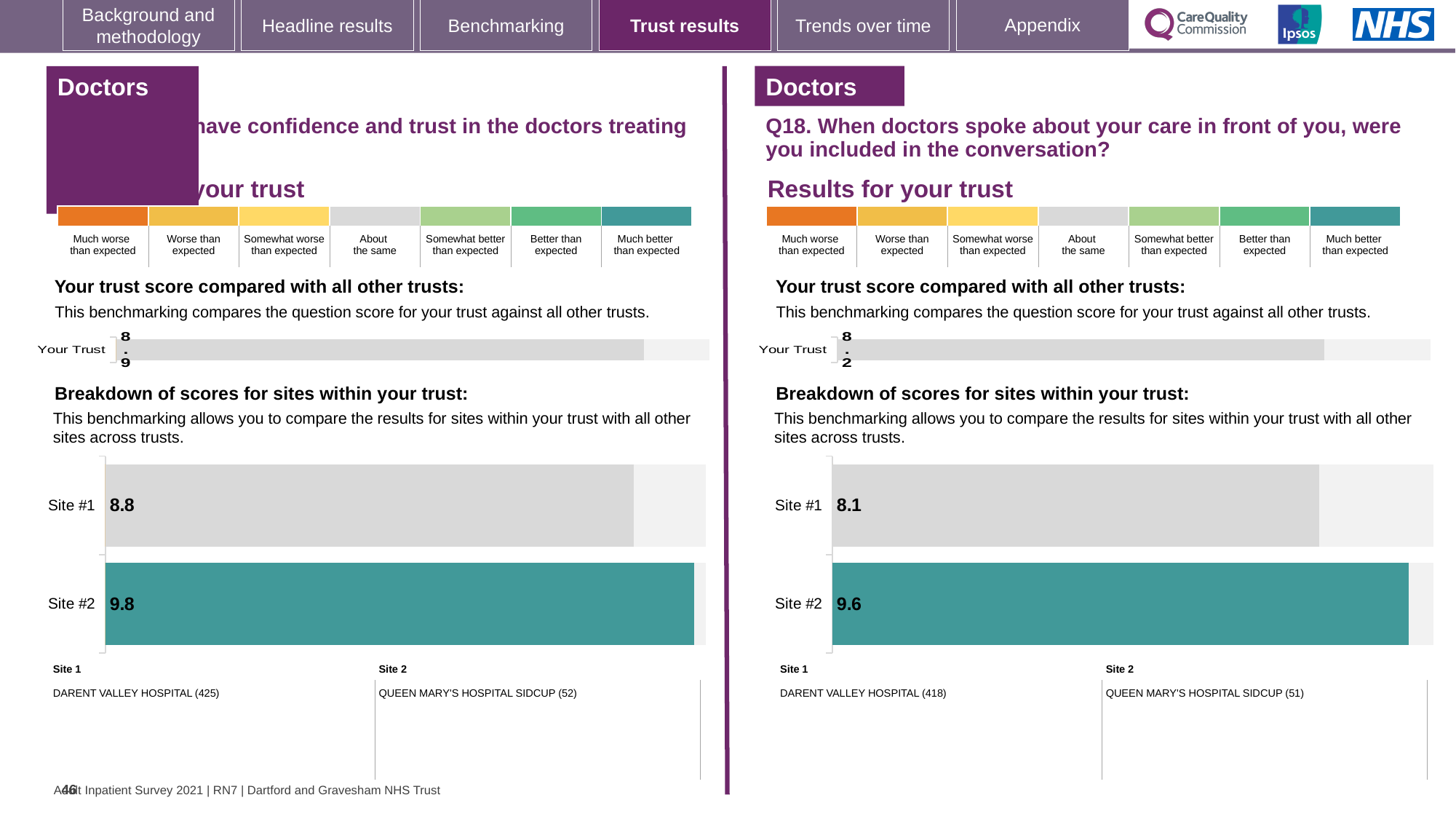
In the left-hand 'Breakdown of scores for sites within your trust' chart, what is the score for Site #1? 8.8 In the Q18 site breakdown chart on the right, how many sites are shown? 2 In the left-hand 'Your trust score compared with all other trusts' chart, what is the score for Your Trust? 8.9 In the left-hand site breakdown chart, what is the difference between the scores for Site #2 and Site #1? 1.0 In the Q18 site breakdown chart on the right, which site has the lowest score? Site #1 In the Q18 site breakdown chart on the right, what is the difference between the scores for Site #2 and Site #1? 1.5 What type of chart is used for the site breakdown on the left-hand side of the slide? Bar chart In the Q18 'Breakdown of scores for sites within your trust' chart on the right, what is the score for Site #1? 8.1 In the Q18 'Your trust score compared with all other trusts' chart on the right, what is the score for Your Trust? 8.2 In the left-hand site breakdown chart, which site has the highest score? Site #2 In the Q18 'Breakdown of scores for sites within your trust' chart on the right, what is the score for Site #2? 9.6 In the left-hand 'Breakdown of scores for sites within your trust' chart, what is the score for Site #2? 9.8